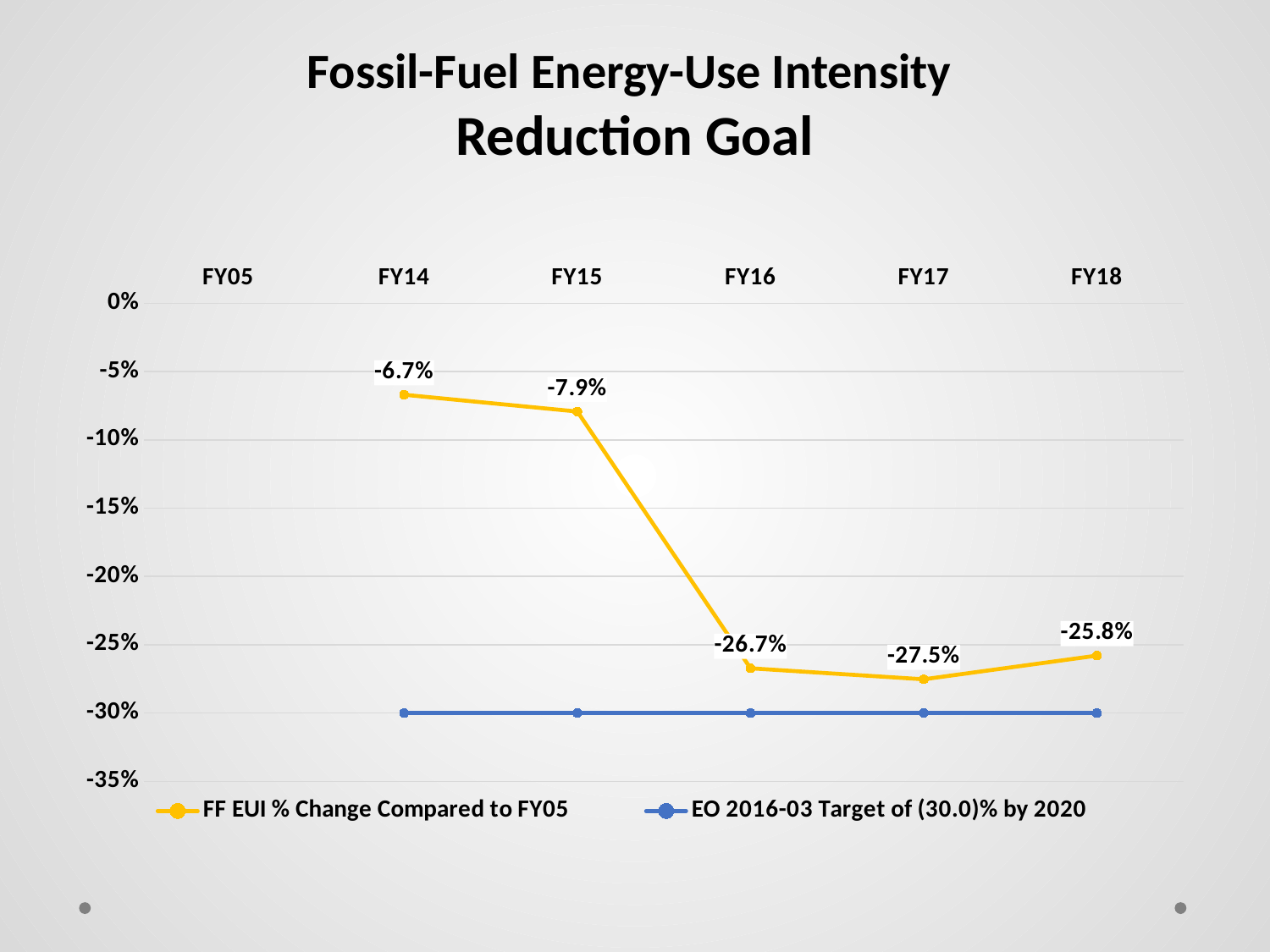
Is the FF EUI % Change for FY15 greater or less than -10%? greater Which is more negative, the FF EUI % Change for FY17 or for FY18? FY17 What is the FF EUI % Change Compared to FY05 value for FY16? -26.7% How many fiscal year labels are shown on the x axis? 6 At what value does the EO 2016-03 Target line sit across all years? -30% What is the FF EUI % Change Compared to FY05 value for FY14? -6.7% In which fiscal year is the FF EUI % Change Compared to FY05 at its highest (least negative) value? FY14 In which fiscal year is the FF EUI % Change Compared to FY05 at its lowest (most negative) value? FY17 What kind of chart is shown on the slide? Line chart How many series does the legend list? 2 What is the FF EUI % Change Compared to FY05 value for FY18? -25.8% What is the difference between the FF EUI % Change values for FY15 and FY16? 18.8%